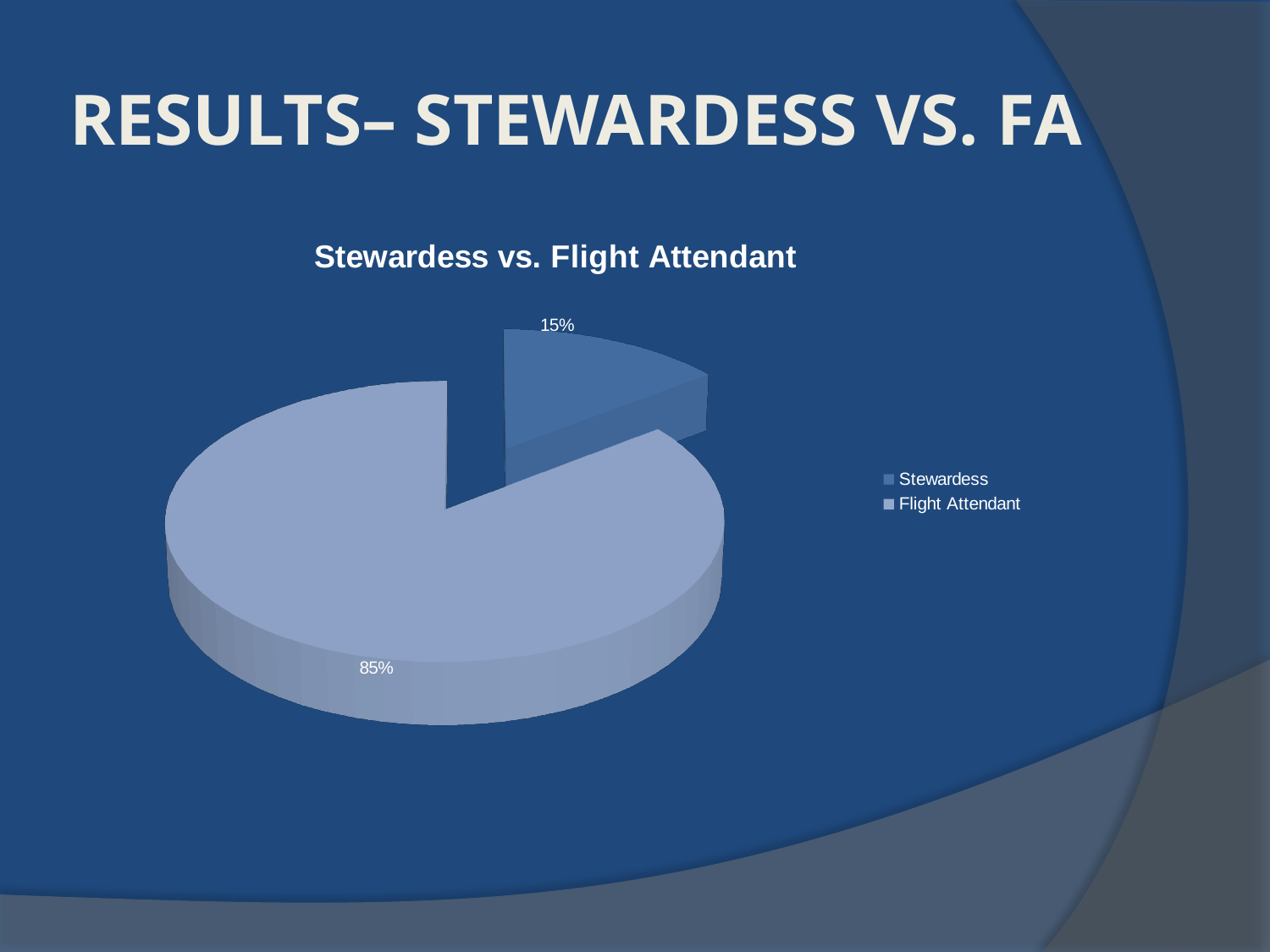
Which category has the smallest slice of the pie? Stewardess What percentage of the pie is labelled for Flight Attendant? 85% Which category has the largest slice of the pie? Flight Attendant How many slices does the pie chart have? 2 What is the title of the chart? Stewardess vs. Flight Attendant Which is larger, the Stewardess slice or the Flight Attendant slice? Flight Attendant What percentage of the pie is labelled for Stewardess? 15% What is the difference in percentage points between the Stewardess and Flight Attendant slices? 70 Which slice is pulled out (exploded) from the rest of the pie? Stewardess How many entries does the legend list? 2 What share of the pie does the Flight Attendant slice represent? 85% What kind of chart is shown on the slide? pie chart